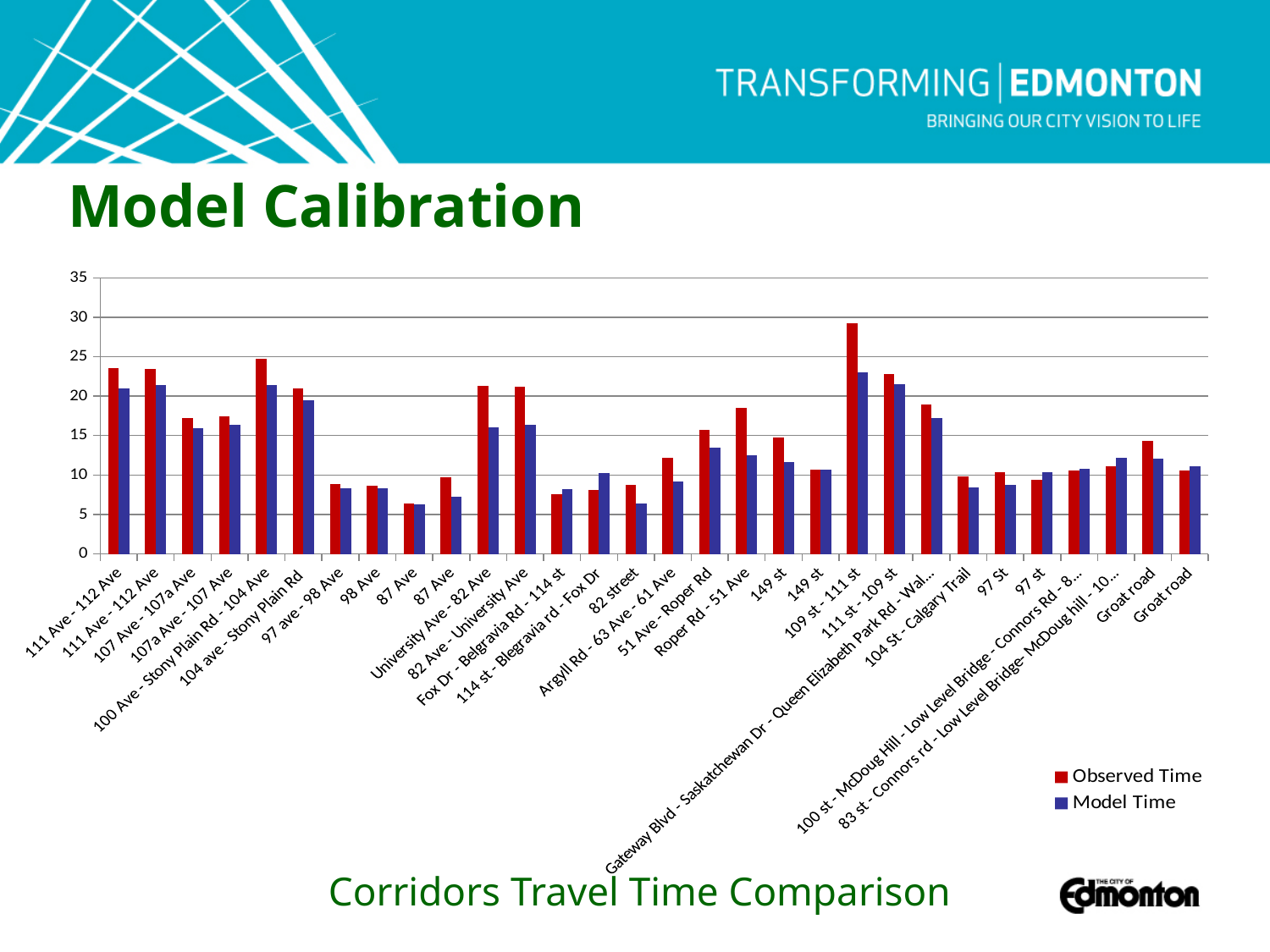
Is the Observed Time for Roper Rd - 51 Ave greater or less than 15? greater What colour represents Observed Time in the chart? red Is the Model Time for 109 st - 111 st greater or less than 20? greater How many series does the chart legend list? 2 Which corridor has the highest Observed Time? 109 st - 111 st What kind of chart is shown on the slide? bar chart Is the Observed Time for 82 street greater or less than 10? less Which corridor has the highest Model Time? 109 st - 111 st What are the two series named in the chart legend? Observed Time and Model Time For 82 Ave - University Ave, which is larger: Observed Time or Model Time? Observed Time